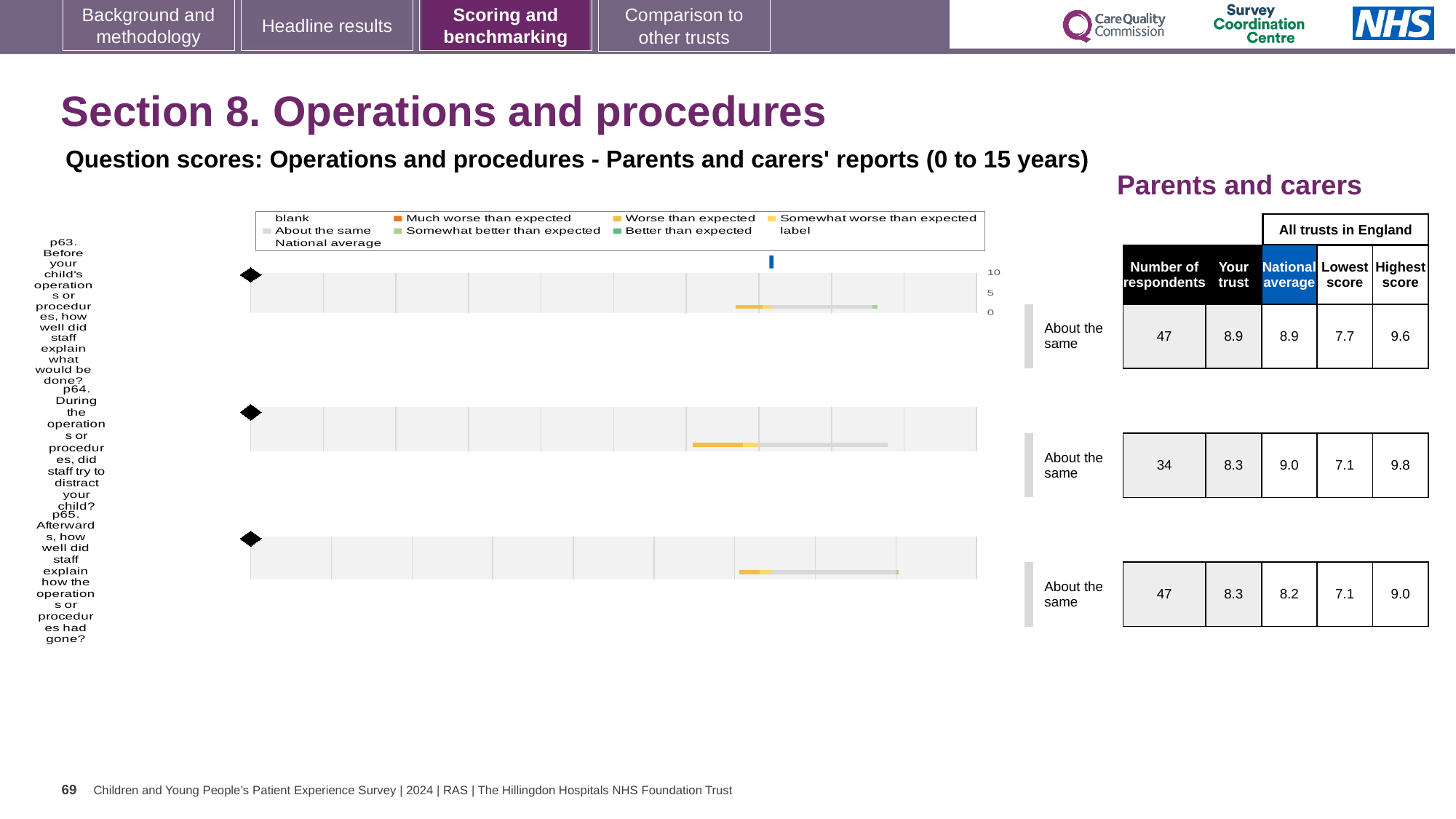
What kind of chart is used to show the question scores on this slide? Bar chart For question p64, which is larger: the 'Your trust' score or the national average? National average How many questions are plotted on this slide? 3 Which question has the highest 'Your trust' score? p63 What is the national average score for question p65 (Afterwards, how well did staff explain how the operations or procedures had gone?)? 8.2 What is the highest score across all trusts in England for question p64? 9.8 How many respondents are shown for question p63 (Before your child's operations or procedures, how well did staff explain what would be done?)? 47 What is the lowest score across all trusts in England for question p63? 7.7 Which question has the lowest national average score? p65 What benchmark category is shown for question p65? About the same What is the 'Your trust' score for question p64 (During the operations or procedures, did staff try to distract your child?)? 8.3 For question p64, what is the difference between the national average and the 'Your trust' score? 0.7